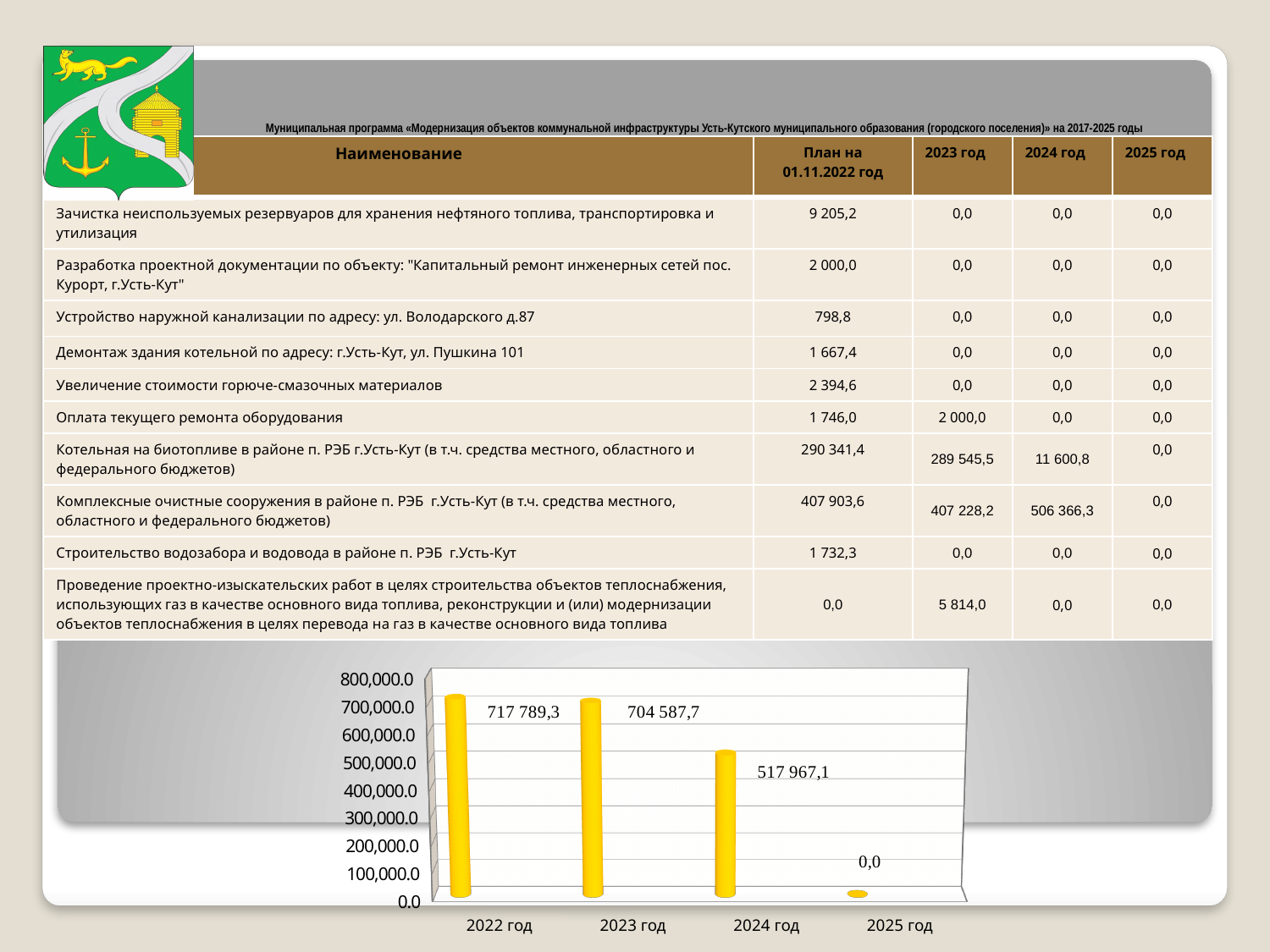
Which year has the lowest value in the chart? 2025 год What is the value shown for 2025 год in the chart? 0,0 Is the value for 2024 год in the chart greater or less than 600,000.0? less What is the difference between the values for 2022 год and 2024 год in the chart? 199 822,2 What is the value shown for 2023 год in the chart? 704 587,7 What is the value shown for 2024 год in the chart? 517 967,1 What is the value shown for 2022 год in the chart? 717 789,3 Which year has the highest value in the chart? 2022 год How many categories are shown on the x axis of the chart? 4 Which is larger in the chart, the value for 2023 год or the value for 2024 год? 2023 год What type of chart is shown at the bottom of the slide? bar chart Do the values in the chart rise or fall from 2022 год to 2025 год? fall